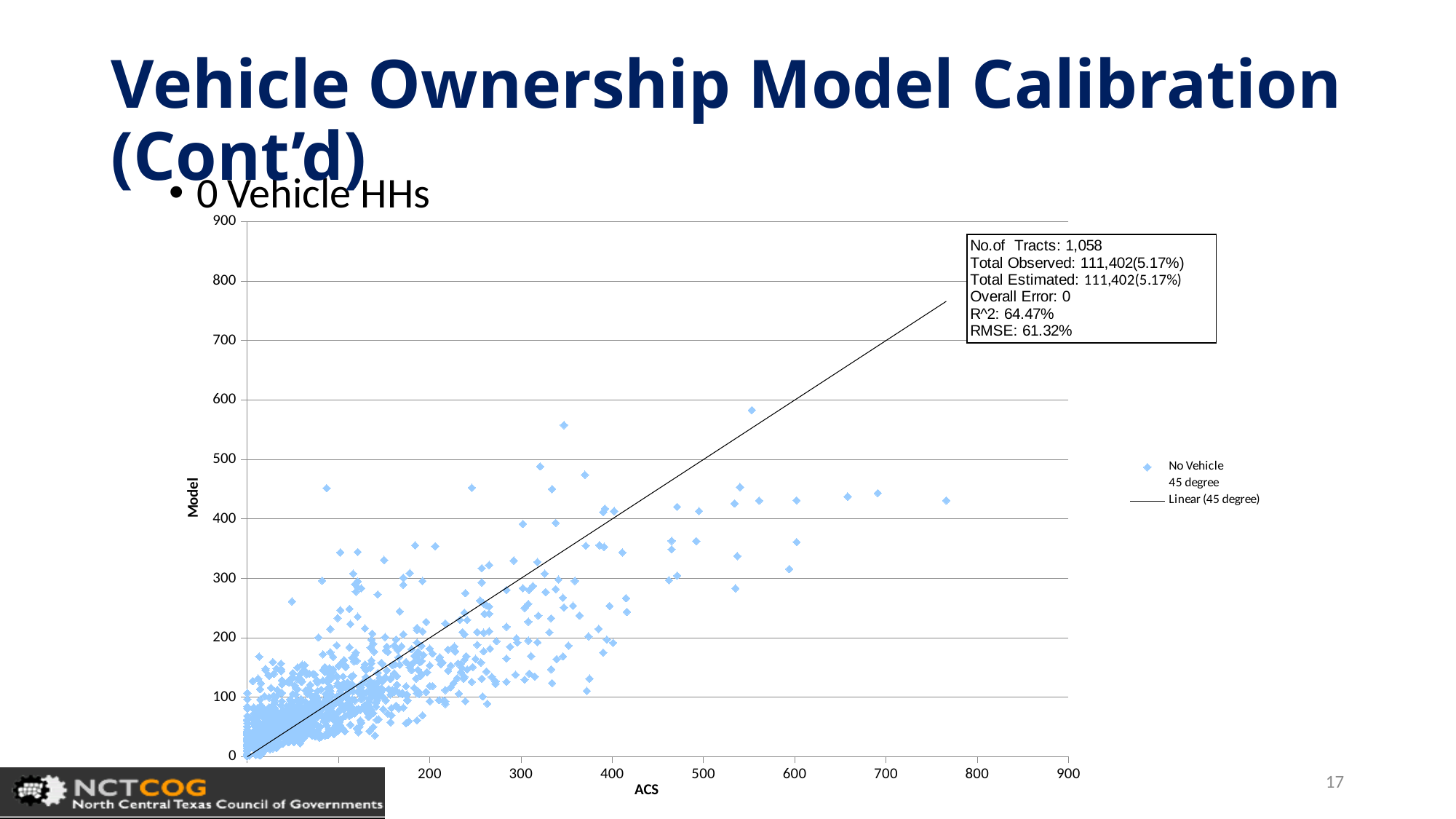
What is the Total Observed value reported in the chart's annotation box? 111,402(5.17%) Do the plotted Model values generally rise or fall as ACS increases along the x axis? rise What RMSE value is reported in the chart's annotation box? 61.32% What is the label of the y axis of the chart? Model Is the largest ACS value plotted in the chart greater or less than 700? greater What Overall Error is reported in the chart's annotation box? 0 How many entries does the chart's legend list? 3 What is the number of tracts reported in the chart's annotation box? 1,058 What is the label of the x axis of the chart? ACS What R^2 value is reported in the chart's annotation box? 64.47% What kind of chart is shown on the slide? Scatter chart Is the highest Model value plotted in the chart greater or less than 500? greater